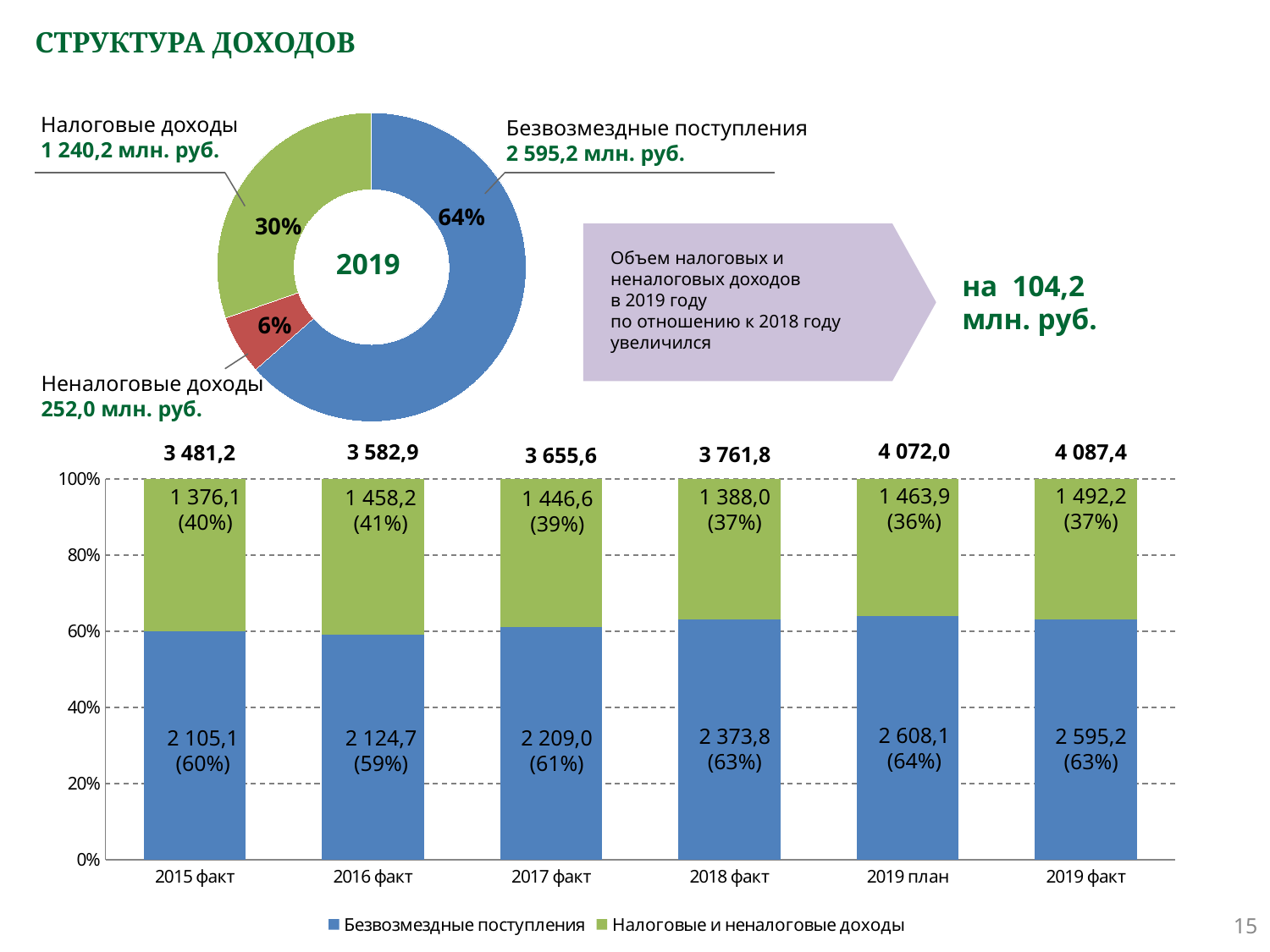
In the stacked bar chart, which is larger for Налоговые и неналоговые доходы: 2016 факт or 2017 факт? 2016 факт In the stacked bar chart, which category has the highest total? 2019 факт In the stacked bar chart, how many series does the legend list? 2 In the donut chart, what share of 2019 income is Безвозмездные поступления? 64% In the donut chart, what is the value shown for Налоговые доходы? 1 240,2 млн. руб. In the stacked bar chart, what is the total shown above the 2019 план bar? 4 072,0 In the stacked bar chart, what is the value of Безвозмездные поступления for 2018 факт? 2 373,8 In the donut chart, what is the value shown for Неналоговые доходы? 252,0 млн. руб. In the stacked bar chart, how many categories are shown on the x axis? 6 In the stacked bar chart, do the totals above the bars rise or fall from 2015 факт to 2019 факт? rise In the donut chart, which category has the smallest slice? Неналоговые доходы In the stacked bar chart, what is the difference between Безвозмездные поступления for 2019 план and 2019 факт? 12,9